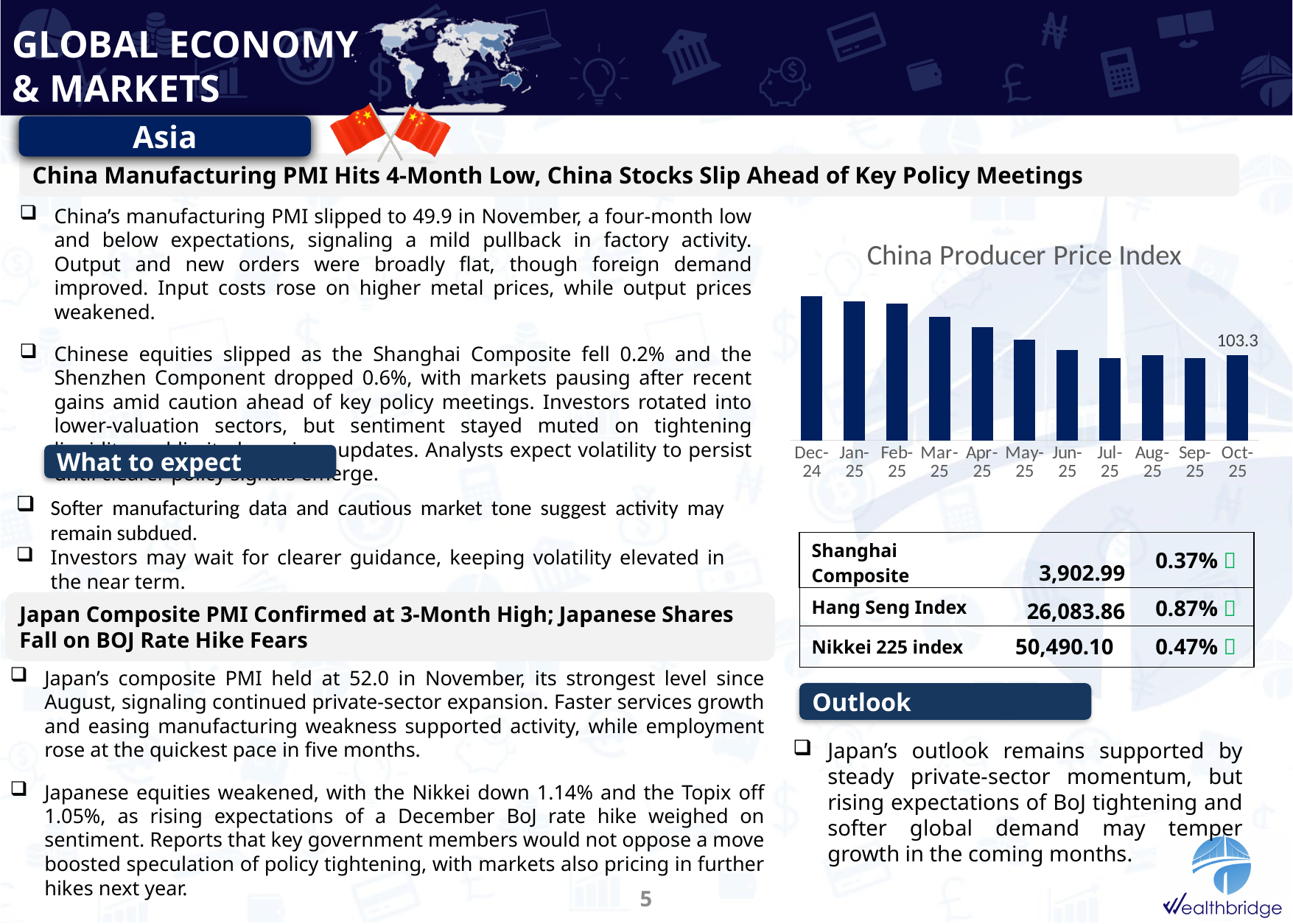
In the China Producer Price Index chart, which is larger, the value for Jan-25 or the value for Apr-25? Jan-25 How many months are plotted in the China Producer Price Index chart? 11 Do the values in the China Producer Price Index chart generally rise or fall from Dec-24 to Jul-25? fall In the China Producer Price Index chart, which is larger, the value for Mar-25 or the value for Jun-25? Mar-25 In the China Producer Price Index chart, which is larger, the value for Dec-24 or the value for Oct-25? Dec-24 Which month is the first category on the x axis of the China Producer Price Index chart? Dec-24 What is the title of the bar chart on the slide? China Producer Price Index What kind of chart is the China Producer Price Index chart? bar chart What is the value shown for Oct-25 in the China Producer Price Index chart? 103.3 Which month has the highest bar in the China Producer Price Index chart? Dec-24